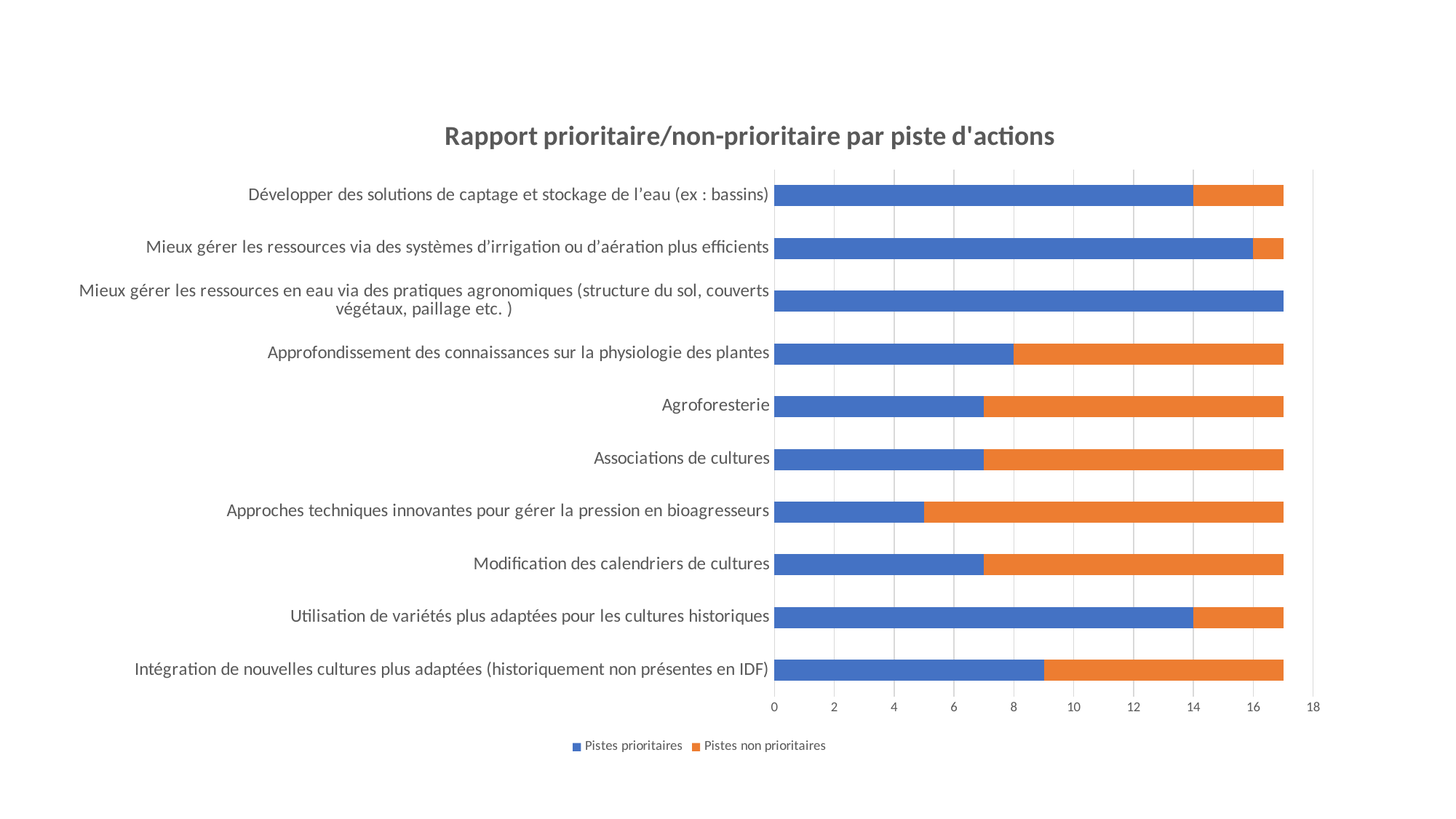
Which category has the highest 'Pistes non prioritaires' value? Approches techniques innovantes pour gérer la pression en bioagresseurs Which category has the lowest 'Pistes prioritaires' value? Approches techniques innovantes pour gérer la pression en bioagresseurs Is the 'Pistes prioritaires' value for 'Agroforesterie' greater or less than 10? less What is the 'Pistes prioritaires' value for 'Mieux gérer les ressources via des systèmes d'irrigation ou d'aération plus efficients'? 16 What kind of chart is shown on the slide? bar chart What is the 'Pistes prioritaires' value for 'Développer des solutions de captage et stockage de l'eau (ex : bassins)'? 14 What is the difference between the 'Pistes prioritaires' values for 'Mieux gérer les ressources via des systèmes d'irrigation ou d'aération plus efficients' and 'Développer des solutions de captage et stockage de l'eau (ex : bassins)'? 2 Which has the larger 'Pistes prioritaires' value: 'Utilisation de variétés plus adaptées pour les cultures historiques' or 'Intégration de nouvelles cultures plus adaptées (historiquement non présentes en IDF)'? Utilisation de variétés plus adaptées pour les cultures historiques How many action categories are plotted on the chart? 10 How many series does the legend list? 2 What is the title of the chart? Rapport prioritaire/non-prioritaire par piste d'actions What is the 'Pistes prioritaires' value for 'Approfondissement des connaissances sur la physiologie des plantes'? 8